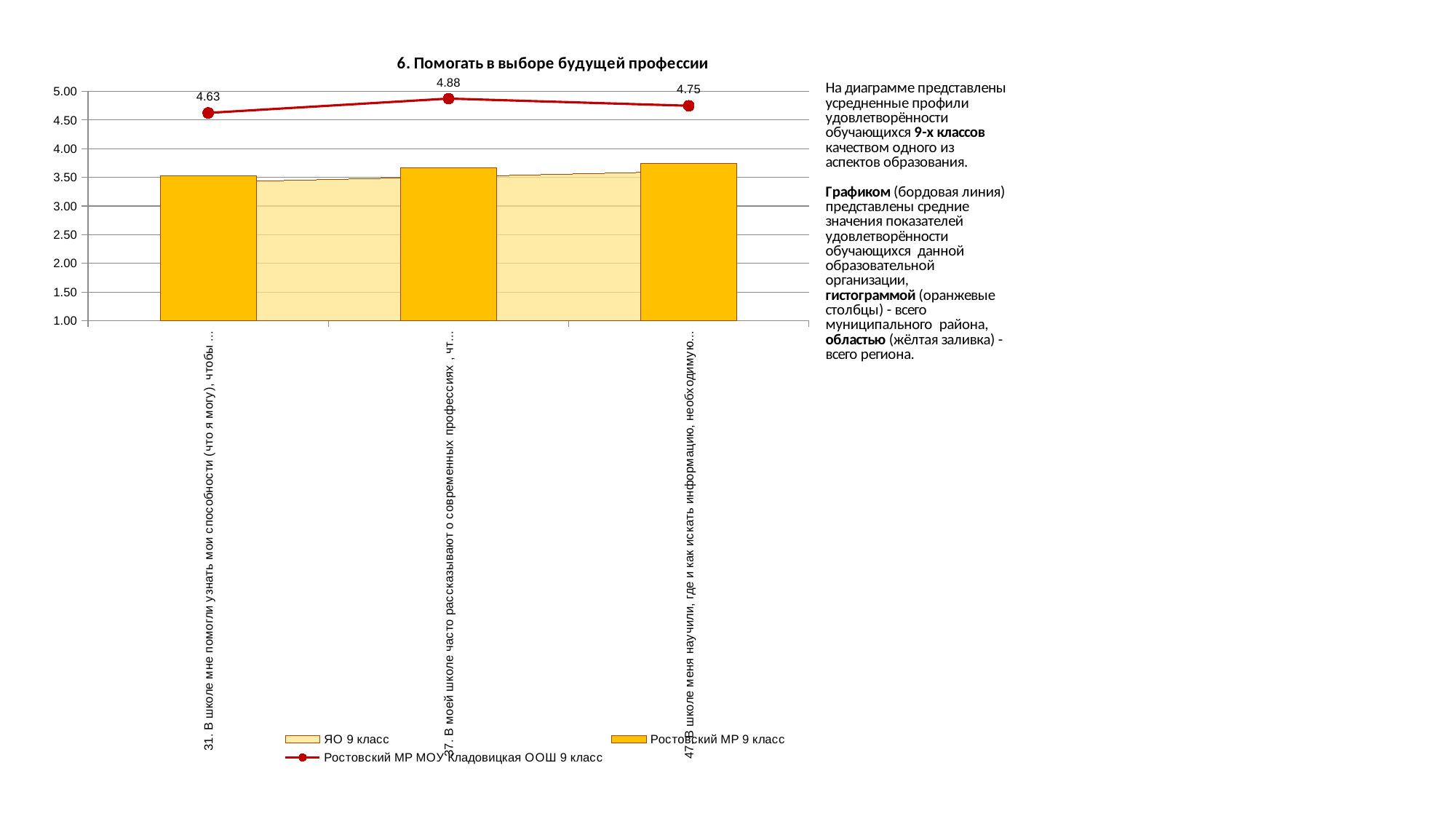
For which item does the Ростовский МР МОУ Кладовицкая ООШ 9 класс line have its lowest value? 31 Which is larger for the Ростовский МР МОУ Кладовицкая ООШ 9 класс line: item 47 or item 31? 47 What is the value of the Ростовский МР МОУ Кладовицкая ООШ 9 класс line for item 37? 4.88 How many series does the legend list? 3 How many items (categories) are shown on the x axis? 3 What is the value of the Ростовский МР МОУ Кладовицкая ООШ 9 класс line for item 47? 4.75 For which item does the Ростовский МР МОУ Кладовицкая ООШ 9 класс line reach its highest value? 37 What is the difference between the line values for item 37 and item 31? 0.25 What is the title of the chart? 6. Помогать в выборе будущей профессии Is the Ростовский МР 9 класс bar for item 37 greater or less than 4.00? less Is the Ростовский МР 9 класс bar for item 47 greater or less than 3.50? greater What is the value of the Ростовский МР МОУ Кладовицкая ООШ 9 класс line for item 31? 4.63